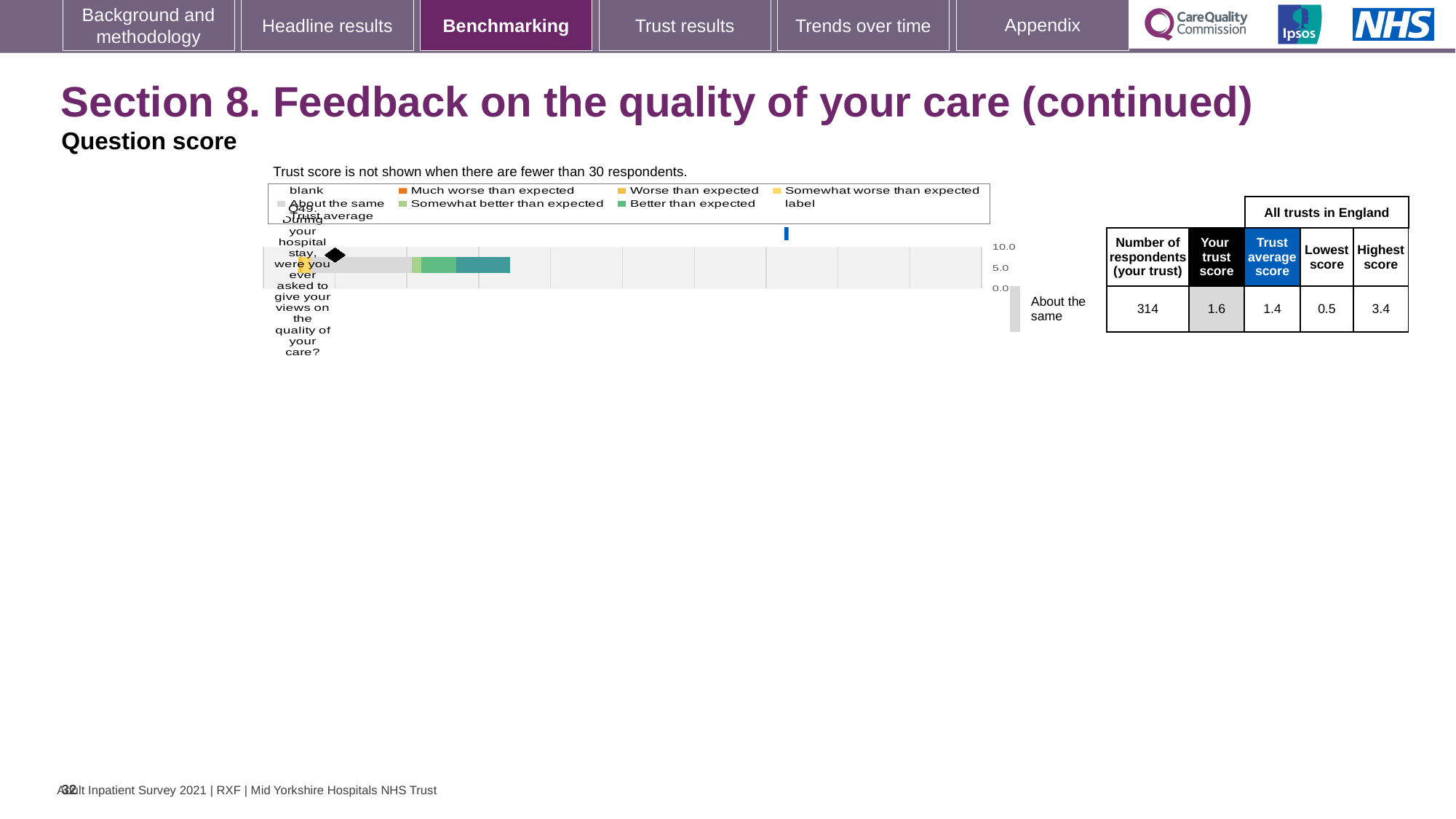
What is the highest value shown on the chart's axis? 10.0 What is your trust score for Q49? 1.6 How many questions (categories) are plotted in the chart? 1 What is the trust average score for Q49? 1.4 What is the number of respondents (your trust) for Q49? 314 Which is larger for Q49: your trust score or the trust average score? Your trust score Which colour in the legend represents 'Much worse than expected'? Orange What is the lowest score among all trusts in England for Q49? 0.5 What kind of chart is shown for Q49 on this slide? Bar chart What benchmark category label is shown next to the chart for Q49? About the same What is the highest score among all trusts in England for Q49? 3.4 Is the trust score marker for Q49 greater or less than 5.0 on the chart axis? less